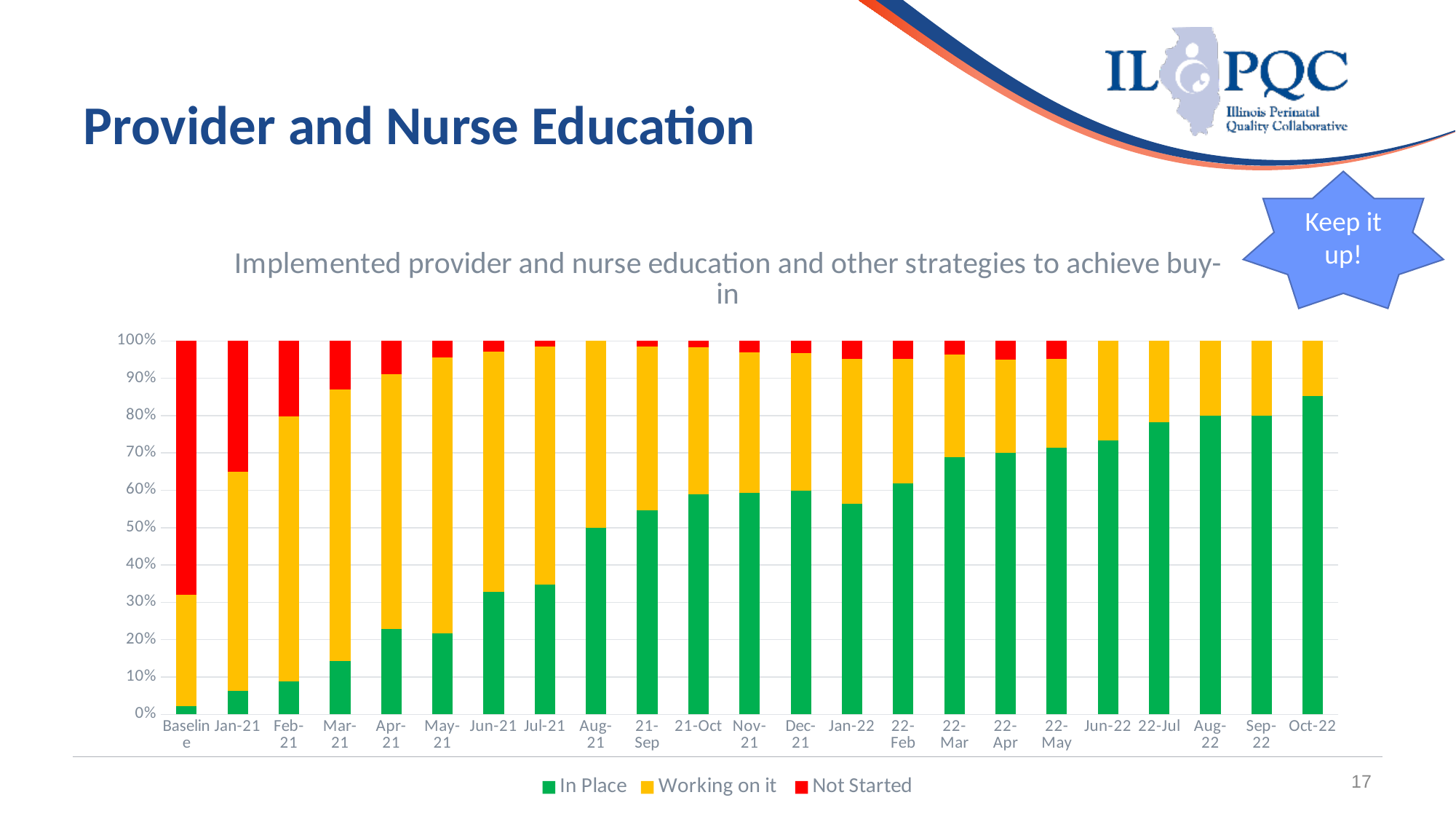
Does the In Place share rise or fall from Baseline to Oct-22? Rise Which category has the lowest In Place share? Baseline How many series does the legend list? 3 What kind of chart is shown on the slide? Stacked bar chart Is the In Place value for Oct-22 greater or less than 80%? greater What is the title of the chart? Implemented provider and nurse education and other strategies to achieve buy-in Is the Not Started value for Baseline greater or less than 50%? greater Which has the larger Not Started share, Baseline or Jan-21? Baseline Is the In Place value for Baseline greater or less than 10%? less Which category has the highest In Place share? Oct-22 How many categories are shown along the x axis? 23 Which series is shown in green in the legend? In Place